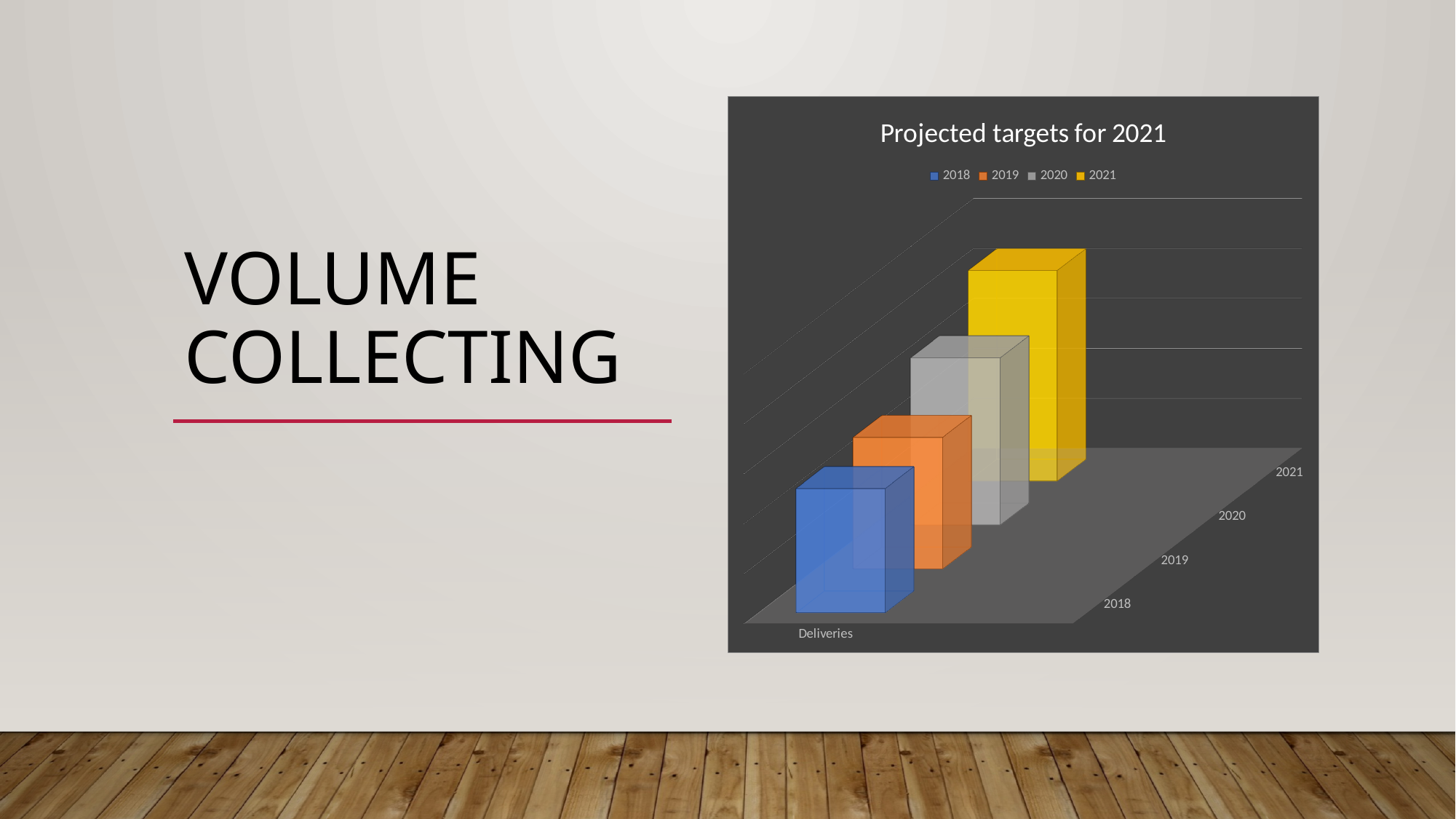
What is the name of the category shown on the chart's horizontal axis? Deliveries Which series has the shortest bar in the chart? 2018 Which bar is taller, 2018 or 2021? 2021 What is the title of the chart? Projected targets for 2021 Which series is shown in yellow in the chart? 2021 What kind of chart is shown on the slide? bar chart Which bar is taller, 2019 or 2020? 2020 How many categories are plotted on the chart's horizontal axis? 1 How many series does the chart's legend list? 4 Do the bars rise or fall from 2018 to 2021? rise Which series has the tallest bar in the chart? 2021